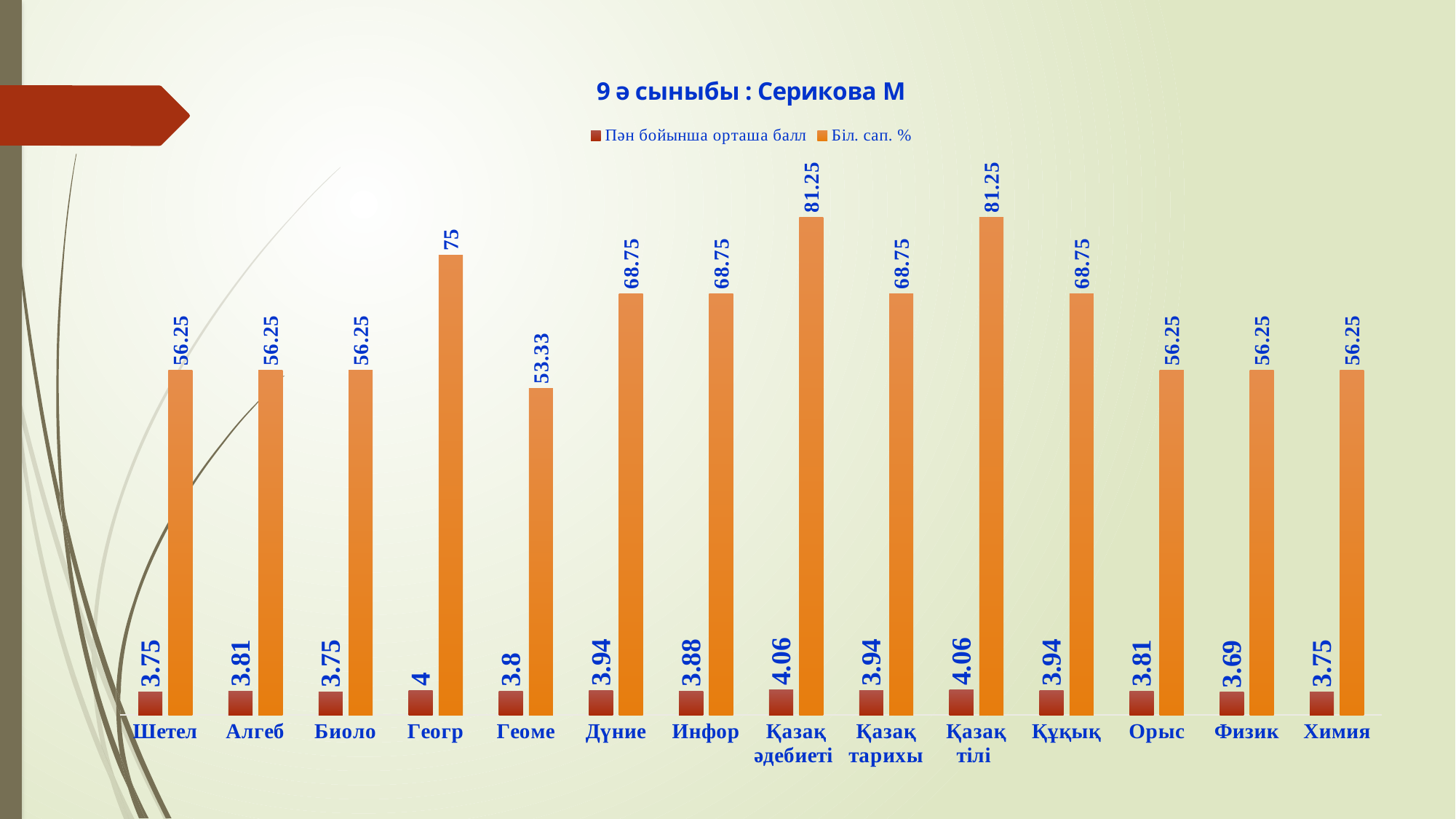
What is the difference between the Пән бойынша орташа балл values for Қазақ әдебиеті and Шетел? 0.31 What type of chart is shown on the slide? bar chart How many series does the legend list? 2 What is the title of the chart? 9 ә сыныбы : Серикова М Which is larger, the Біл. сап. % value for Геогр or for Дүние? Геогр Which subject has the lowest Пән бойынша орташа балл value? Физик How many subject categories are shown on the x axis? 14 What is the value of Біл. сап. % for Геоме? 53.33 Which subject has the lowest Біл. сап. % value? Геоме What is the difference between the Біл. сап. % values for Қазақ тілі and Құқық? 12.5 What is the value of Біл. сап. % for Геогр? 75 What is the value of Пән бойынша орташа балл for Инфор? 3.88